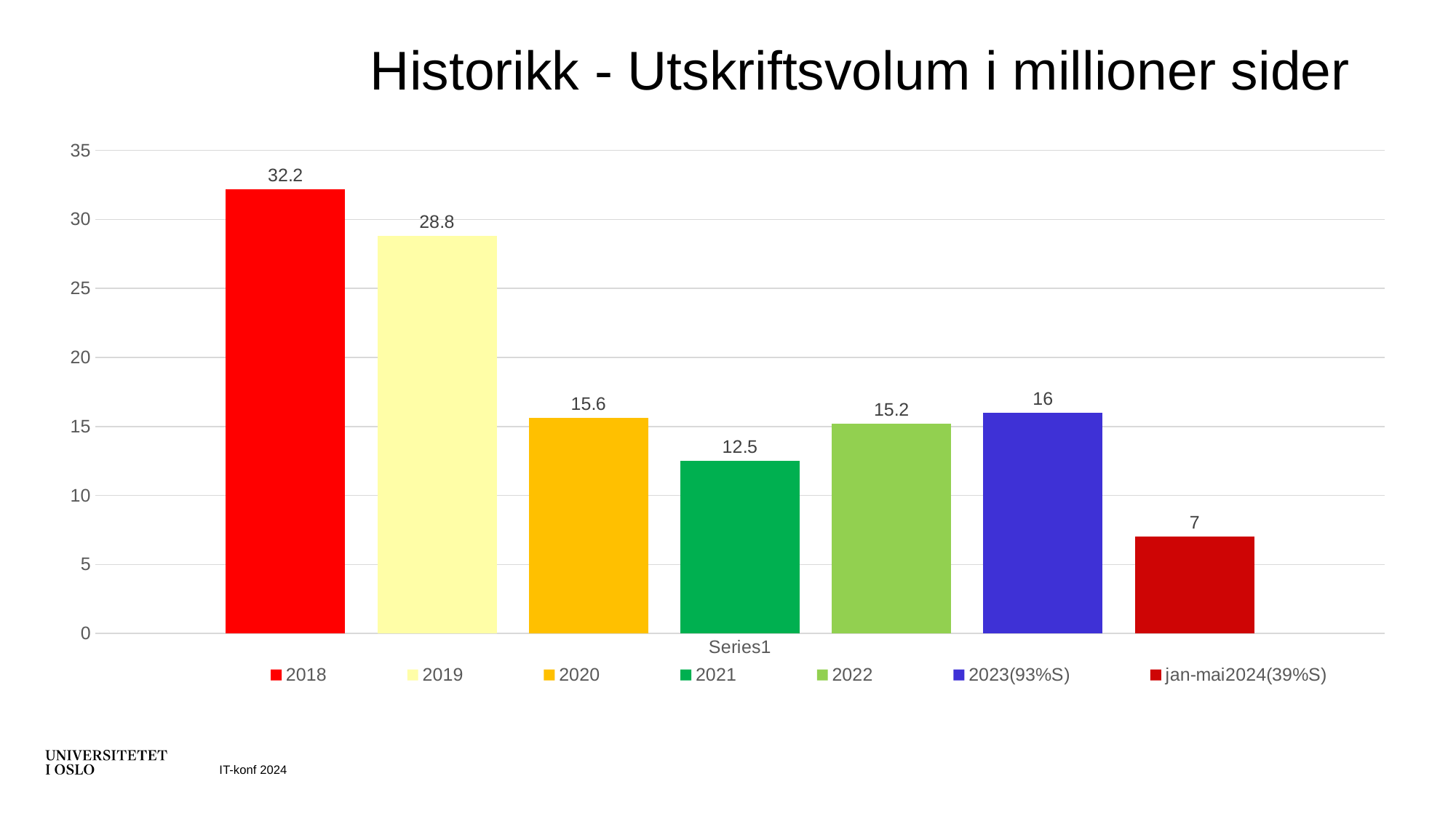
What is the difference between the values for 2020 and 2021? 3.1 What is the difference between the values for 2018 and 2019? 3.4 What value is shown for jan-mai2024(39%S)? 7 How many entries does the legend list? 7 Which year has the highest print volume? 2018 What is the print volume value shown for 2018? 32.2 Which is larger, the value for 2022 or the value for 2023(93%S)? 2023(93%S) What value is shown for 2021? 12.5 Which legend entry has the lowest value? jan-mai2024(39%S) How many bars are plotted in the chart? 7 What is the title of the chart? Historikk - Utskriftsvolum i millioner sider What kind of chart is shown on the slide? bar chart